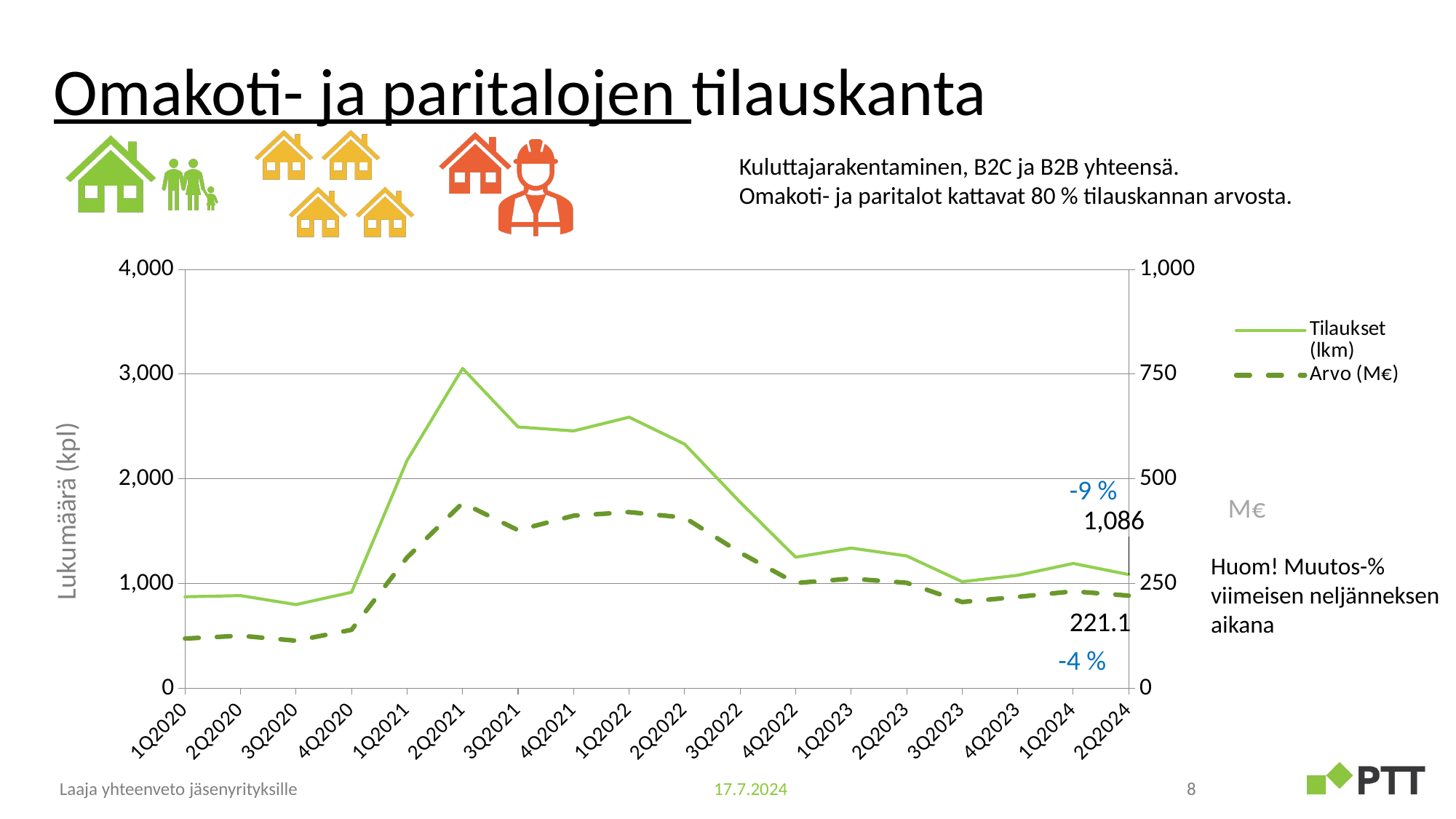
Is the value for Arvo (M€) in 2Q2021 greater or less than 250 on the right axis? greater What is the value of Arvo (M€) in 2Q2024? 221.1 Is the value for Tilaukset (lkm) in 1Q2020 greater or less than 1,000? less Does the Tilaukset (lkm) series rise or fall from 2Q2021 to 4Q2022? fall In which quarter is the Tilaukset (lkm) series at its lowest? 3Q2020 What is the change percentage shown for Tilaukset (lkm) over the last quarter? -9 % What is the change percentage shown for Arvo (M€) over the last quarter? -4 % What type of chart is shown on the slide? line chart How many quarters are plotted along the x axis of the chart? 18 What is the value of Tilaukset (lkm) in 2Q2024? 1,086 In which quarter does the Tilaukset (lkm) series reach its highest value? 2Q2021 How many series does the chart legend list? 2